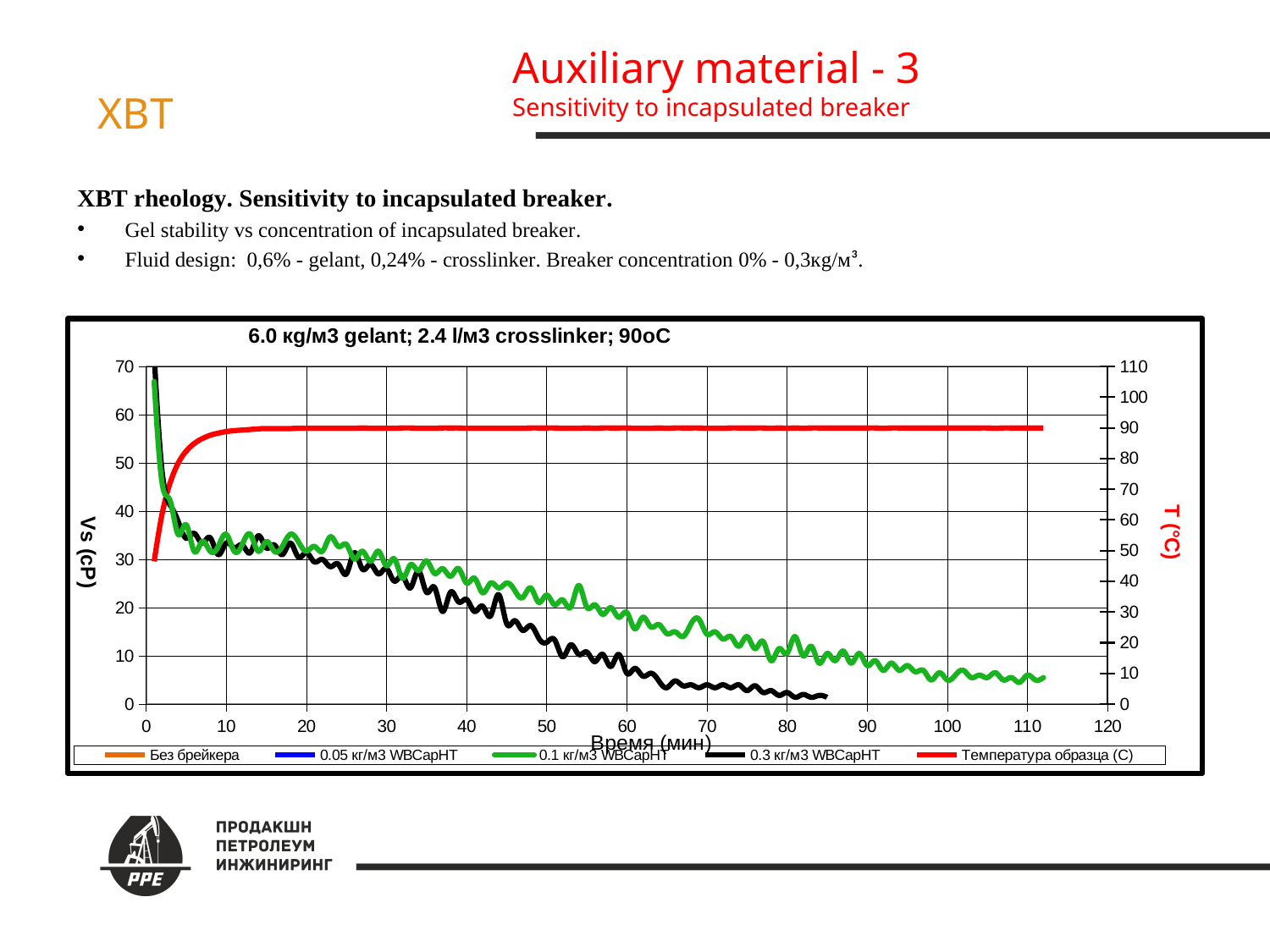
What kind of chart is shown on the slide? line chart How many series does the chart legend list? 5 Does the viscosity (Vs) for 0.1 кг/м3 WBCapHT rise or fall as time increases along the x axis? fall Does the viscosity (Vs) for 0.3 кг/м3 WBCapHT rise or fall as time increases along the x axis? fall What colour is the line for Температура образца (C) in the chart? red At 60 minutes, which series has the higher Vs value: 0.1 кг/м3 WBCapHT or 0.3 кг/м3 WBCapHT? 0.1 кг/м3 WBCapHT Is the sample temperature (Температура образца) at 60 minutes greater or less than 80 °C? greater Is the Vs value for 0.1 кг/м3 WBCapHT at 110 minutes greater or less than 10 cP? less What is the maximum value shown on the right T (°C) axis? 110 Is the Vs value for 0.3 кг/м3 WBCapHT at 80 minutes greater or less than 10 cP? less What is the title of the chart? 6.0 кg/м3 gelant; 2.4 l/м3 crosslinker; 90oC What is the maximum value shown on the left Vs (cP) axis? 70